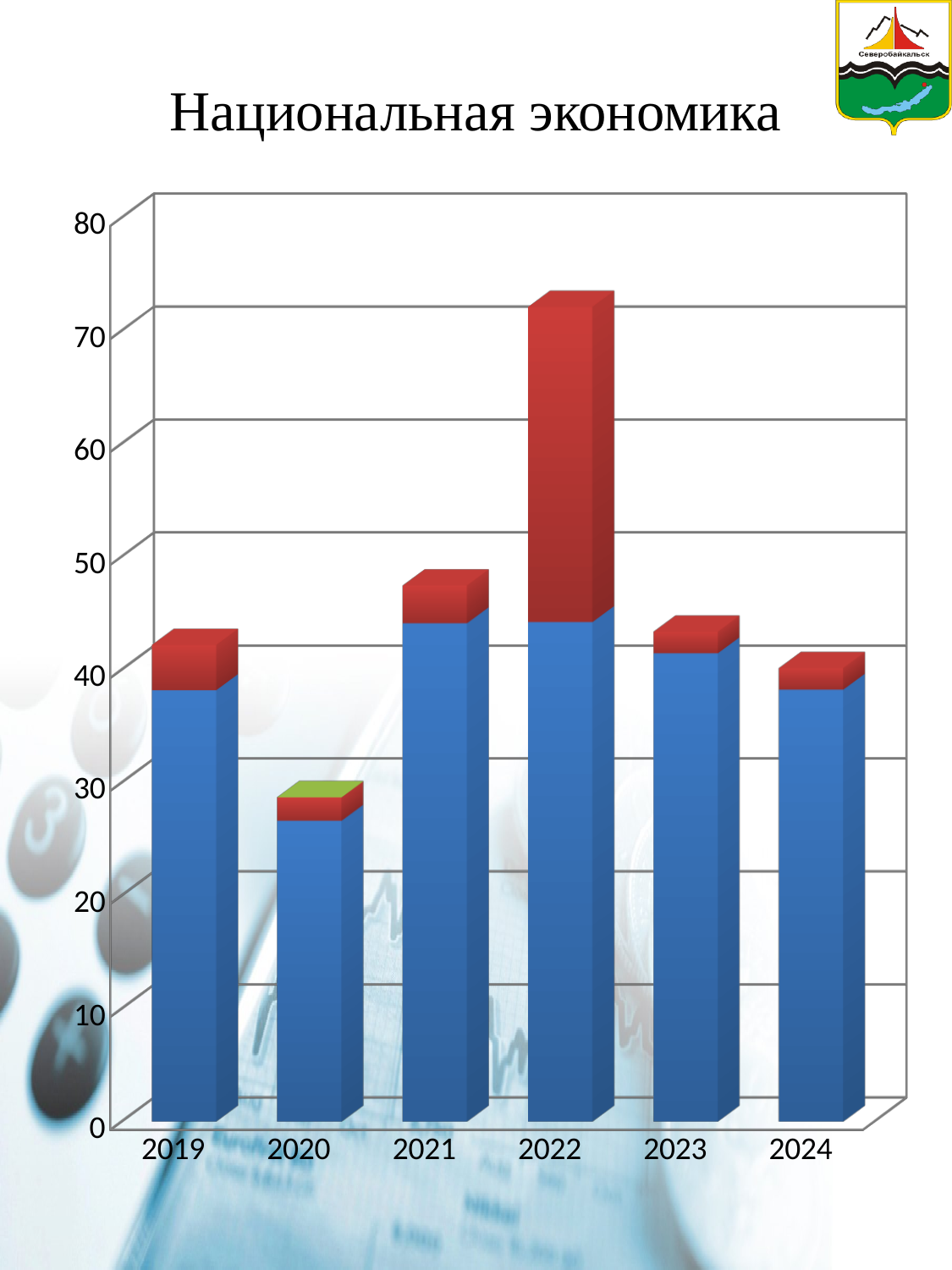
Which year's bar includes a green segment at the top? 2020 Is the total value for 2021 greater or less than 40? greater Is the total value for 2020 greater or less than 40? less Which year has the tallest bar in the chart? 2022 How many years are shown on the x axis of the chart? 6 Which bar is taller, 2024 or 2020? 2024 Is the total value for 2022 greater or less than 60? greater What is the title of the chart? Национальная экономика Which year has the shortest bar in the chart? 2020 Do the bar values rise or fall from 2022 to 2024? fall Which bar is taller, 2022 or 2019? 2022 What kind of chart is shown on the slide? bar chart